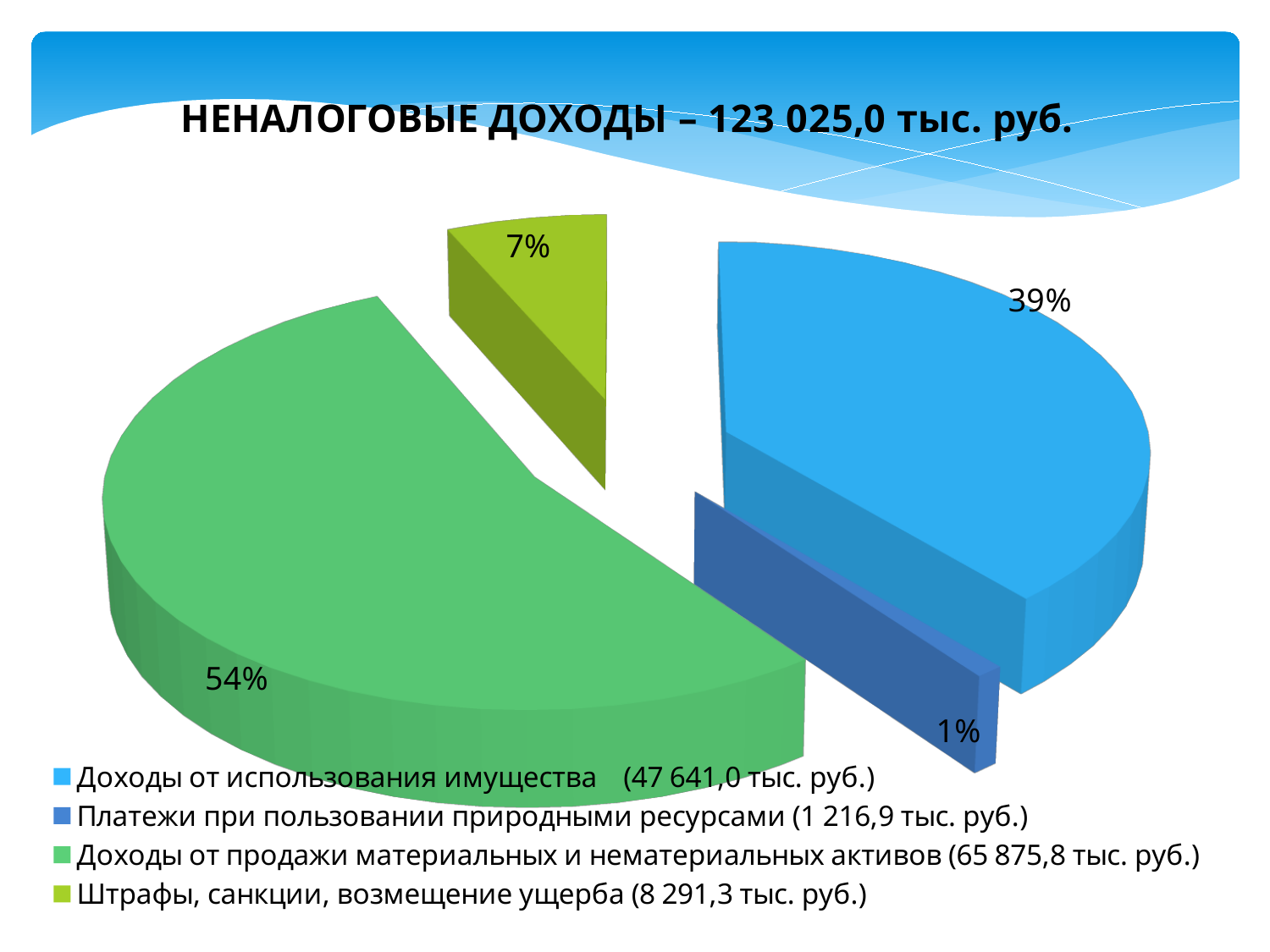
What is the title of the chart on the slide? НЕНАЛОГОВЫЕ ДОХОДЫ – 123 025,0 тыс. руб. What share of the pie is 'Штрафы, санкции, возмещение ущерба'? 7% How many slices does the pie chart have? 4 Which has a larger share: 'Штрафы, санкции, возмещение ущерба' or 'Платежи при пользовании природными ресурсами'? Штрафы, санкции, возмещение ущерба What share of the pie is 'Доходы от продажи материальных и нематериальных активов'? 54% What share of the pie is 'Доходы от использования имущества'? 39% Which category has the smallest share of the pie? Платежи при пользовании природными ресурсами What is the difference in percentage points between the shares of 'Доходы от продажи материальных и нематериальных активов' and 'Доходы от использования имущества'? 15 percentage points Which category has the largest share of the pie? Доходы от продажи материальных и нематериальных активов What amount does the legend give for 'Доходы от использования имущества'? 47 641,0 тыс. руб. What kind of chart is shown on the slide? Pie chart